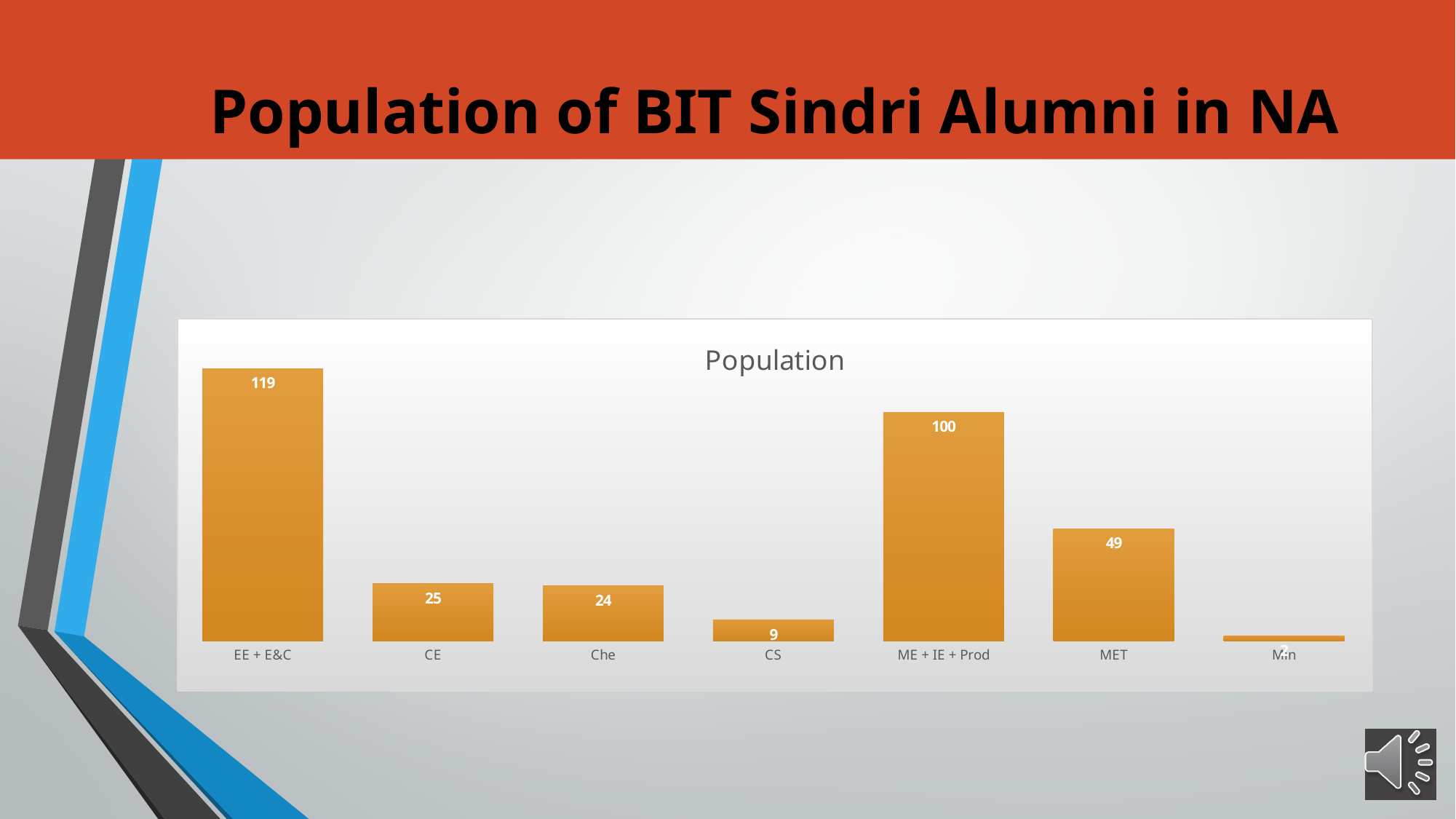
What is the title of the chart? Population What is the difference between the values for CE and Che? 1 Which category has the highest value? EE + E&C What is the difference between the values for EE + E&C and ME + IE + Prod? 19 Which category has the lowest value? Min What is the value for EE + E&C? 119 How many categories are shown in the chart? 7 What is the value for CS? 9 What kind of chart is shown on the slide? Bar chart Which is larger, the value for MET or the value for CE? MET What is the value for MET? 49 What is the value for ME + IE + Prod? 100